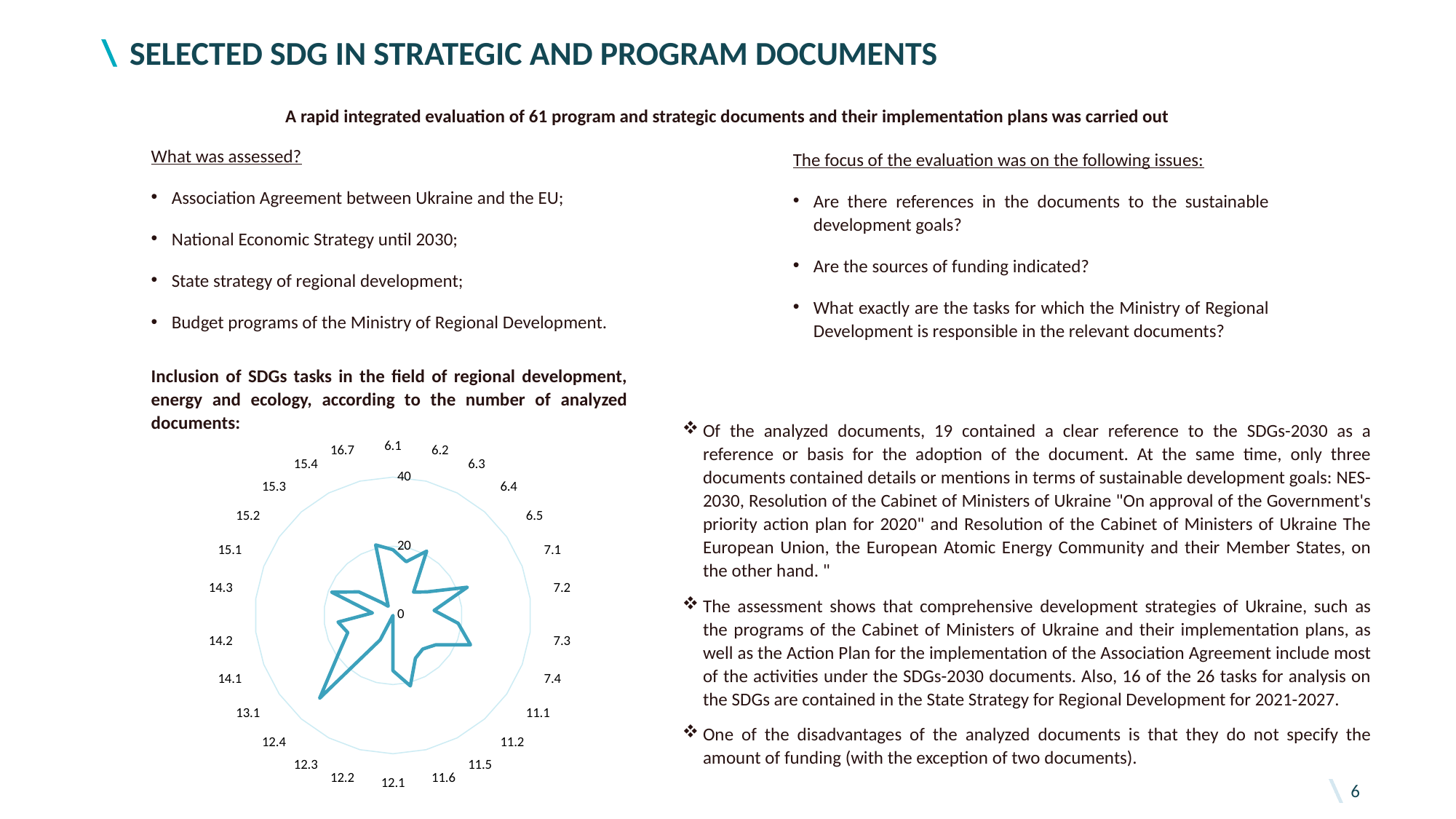
Is the value for 11.1 greater or less than 20? less Which SDG task has the highest value on the radar chart? 12.4 Is the value for 15.2 greater or less than 20? less Is the value for 6.5 greater or less than 20? less What kind of chart is shown on the slide? radar chart What is the highest tick value shown on the radar chart's axis? 40 How many SDG task categories are plotted on the radar chart? 26 What is the first SDG task label at the top of the radar chart? 6.1 Which is larger on the radar chart, the value for 13.1 or the value for 11.1? 13.1